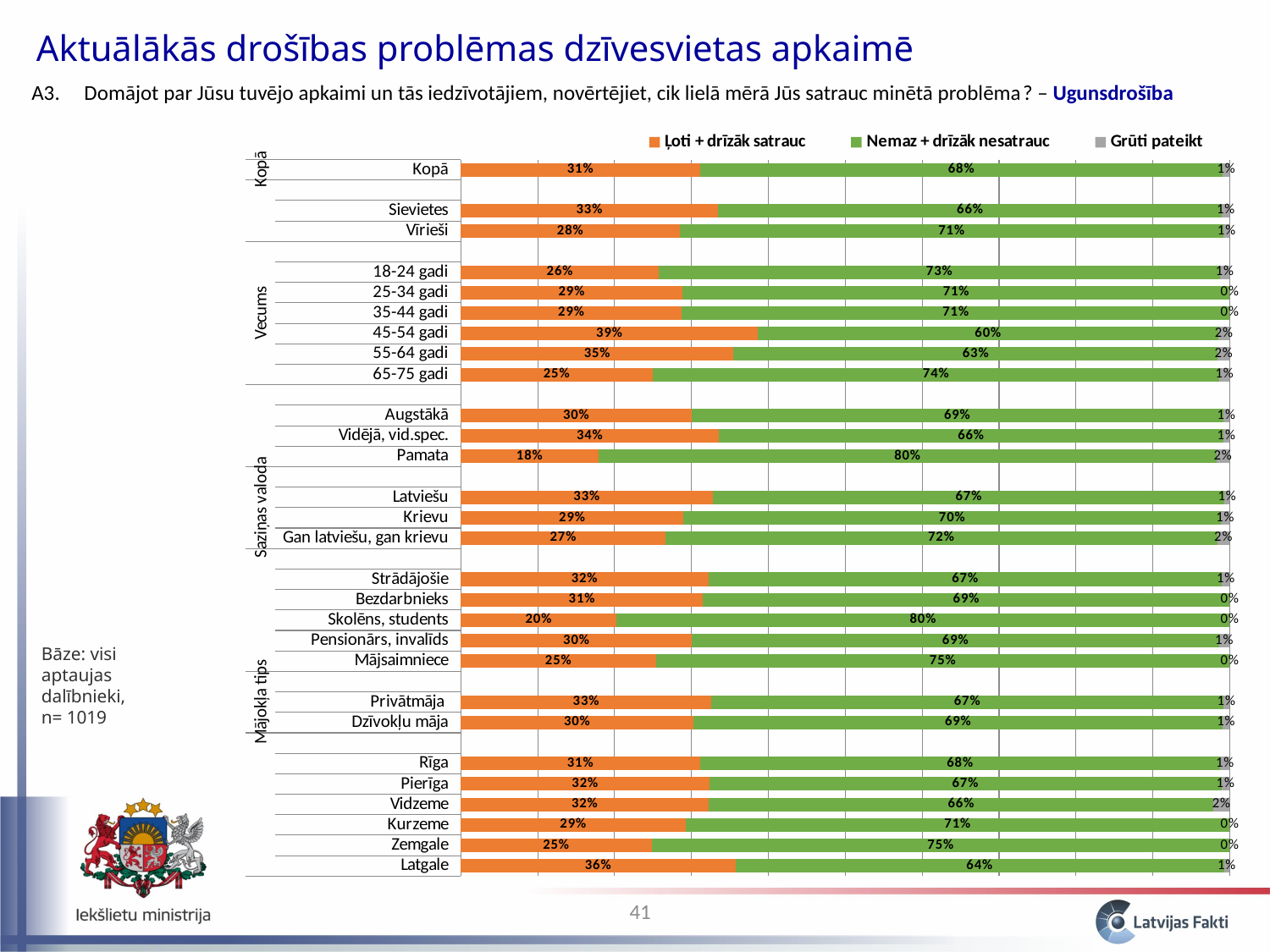
What is the value of "Ļoti + drīzāk satrauc" for Skolēns, students? 20% What is the value of "Nemaz + drīzāk nesatrauc" for Pamata? 80% What is the value of "Grūti pateikt" for 45-54 gadi? 2% How many series does the legend list? 3 Which has a larger "Nemaz + drīzāk nesatrauc" value, Latviešu or Krievu? Krievu Which series is shown in orange in the legend? Ļoti + drīzāk satrauc What is the value of "Ļoti + drīzāk satrauc" for Kopā? 31% Among the age groups (Vecums), which category has the highest "Ļoti + drīzāk satrauc" value? 45-54 gadi What is the difference between the "Ļoti + drīzāk satrauc" values for Sievietes and Vīrieši? 5 percentage points Among the regions (Rīga to Latgale), which category has the lowest "Ļoti + drīzāk satrauc" value? Zemgale What kind of chart is shown on the slide? Stacked bar chart What is the total of the stacked bar for Latgale? 101%